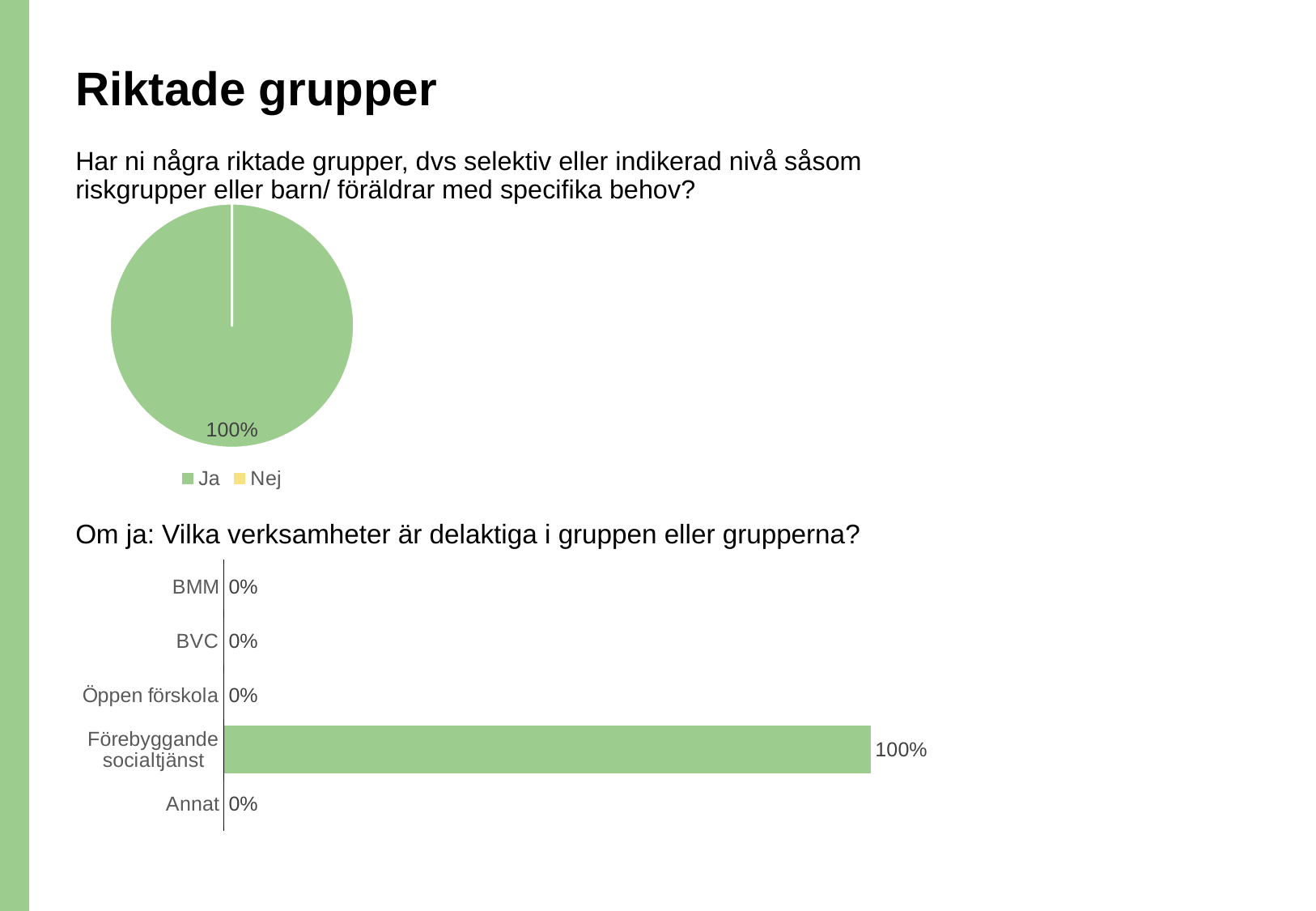
In the pie chart at the top of the slide, what share of the pie does the 'Ja' slice take? 100% How many categories are shown in the bottom bar chart? 5 How many entries does the legend of the pie chart at the top of the slide list? 2 In the bottom bar chart, what is the value for 'Förebyggande socialtjänst'? 100% In the bottom bar chart, what is the value for 'Öppen förskola'? 0% In the bottom bar chart, which is larger: the value for 'BMM' or the value for 'Förebyggande socialtjänst'? Förebyggande socialtjänst In the bottom bar chart, which category has the highest value? Förebyggande socialtjänst In the bottom bar chart, what is the difference between the values for 'Förebyggande socialtjänst' and 'Annat'? 100% What kind of chart is the top chart on the slide? pie chart In the bottom bar chart, what is the value for 'BVC'? 0% What kind of chart is the bottom chart on the slide (under 'Om ja: Vilka verksamheter är delaktiga i gruppen eller grupperna?')? bar chart What are the two legend entries of the pie chart at the top of the slide? Ja and Nej